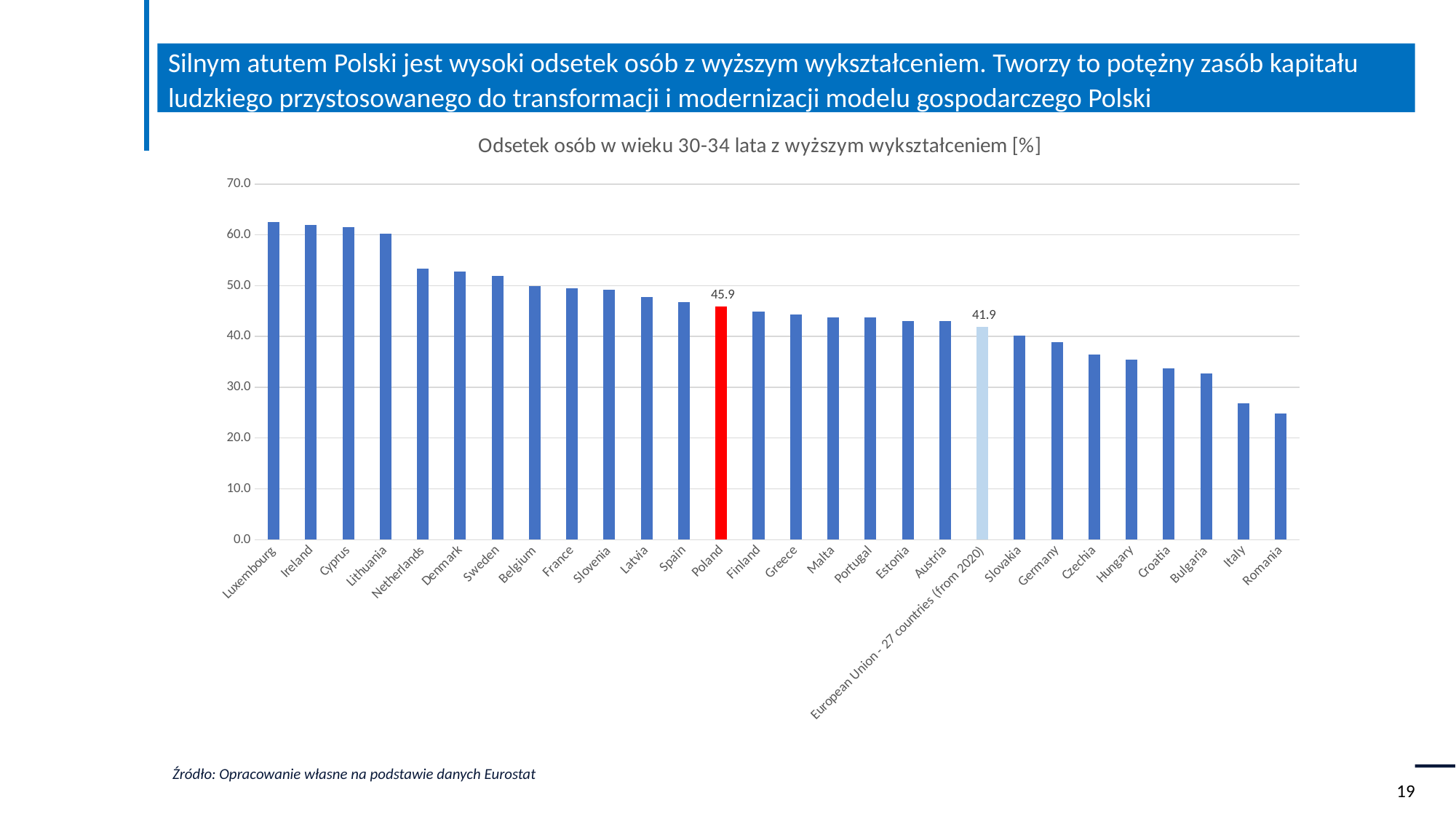
Is the value for Luxembourg greater or less than 60.0? greater Which is larger, the value for Poland or the value for European Union - 27 countries (from 2020)? Poland Is the value for Italy greater or less than 30.0? less What type of chart is shown on the slide? bar chart Do the values rise or fall from left to right along the x axis? fall What is the value for Poland? 45.9 Is the value for Netherlands greater or less than 50.0? greater What is the value for European Union - 27 countries (from 2020)? 41.9 Which category has the lowest value? Romania How many categories are shown on the x axis? 28 What is the title of the chart? Odsetek osób w wieku 30-34 lata z wyższym wykształceniem [%] What is the difference between the value for Poland and the value for European Union - 27 countries (from 2020)? 4.0